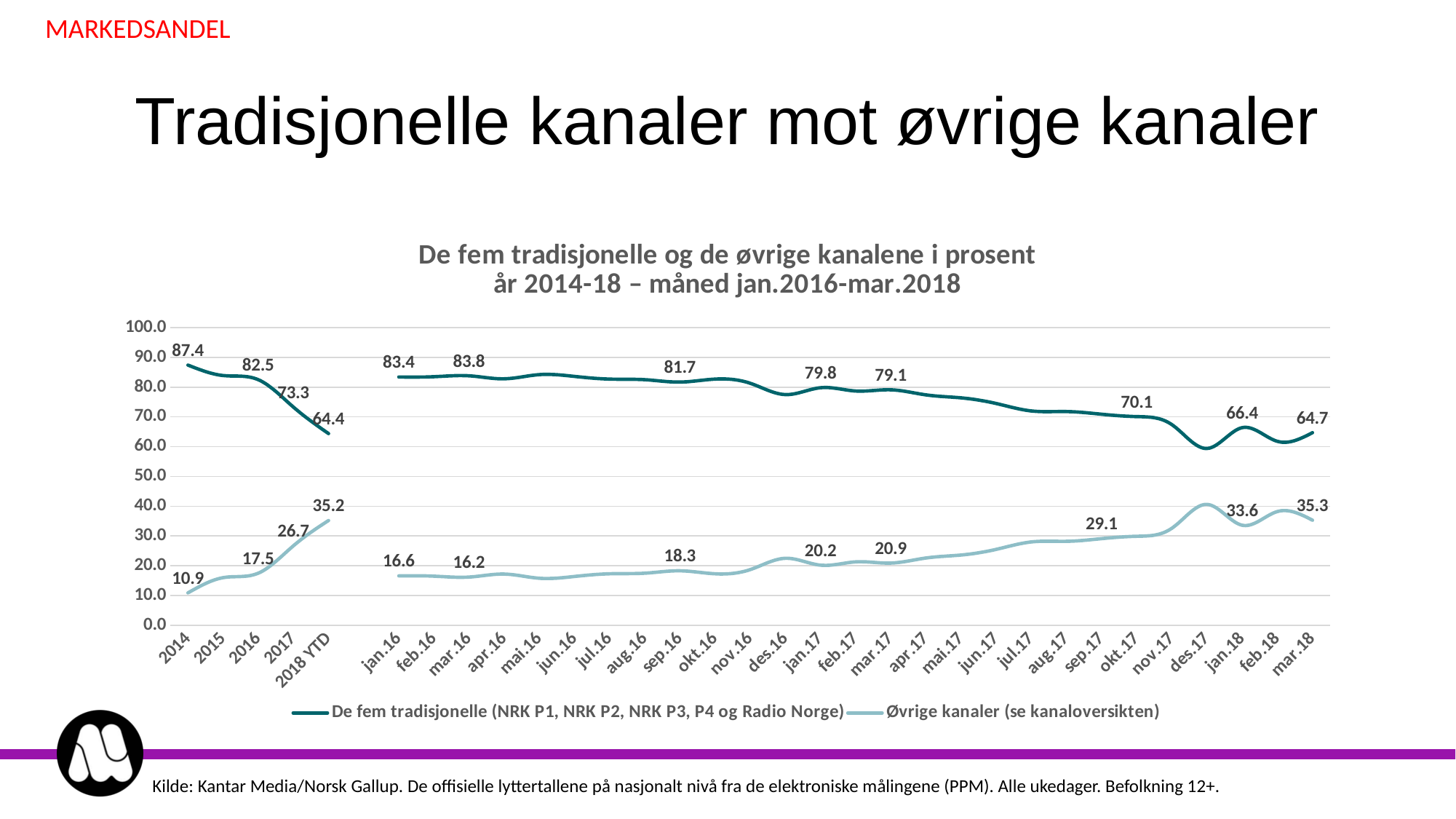
Is the value for Øvrige kanaler in des.17 greater or less than 30.0? greater How many series does the legend list? 2 What is the value for Øvrige kanaler in jan.17? 20.2 Does the Øvrige kanaler series rise or fall from jan.16 to mar.18? rise What is the value for De fem tradisjonelle in 2014? 87.4 What is the value for De fem tradisjonelle in mar.18? 64.7 What kind of chart is shown? line chart What is the value for De fem tradisjonelle in okt.17? 70.1 What is the value for Øvrige kanaler in 2018 YTD? 35.2 Which is larger: the De fem tradisjonelle value in jan.16 or in mar.18? jan.16 What is the difference between the De fem tradisjonelle values in 2014 and 2018 YTD? 23.0 What is the difference between the Øvrige kanaler values in mar.18 and jan.16? 18.7